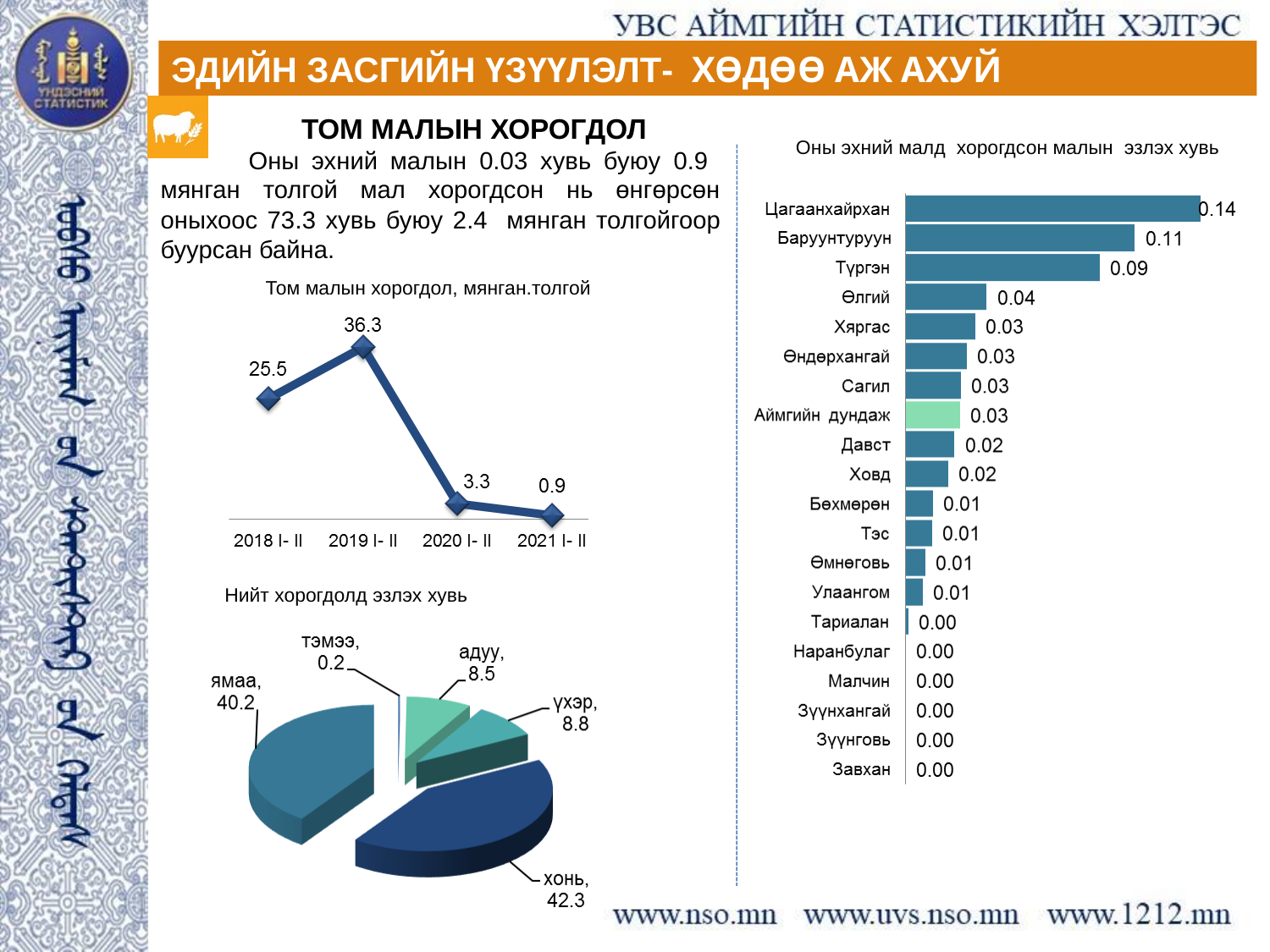
In the bar chart 'Оны эхний малд хорогдсон малын эзлэх хувь', which category has the highest value? Цагаанхайрхан In the line chart 'Том малын хорогдол, мянган.толгой', how many data points are plotted? 4 In the bar chart 'Оны эхний малд хорогдсон малын эзлэх хувь', what is the value for Баруунтуруун? 0.11 In the line chart 'Том малын хорогдол, мянган.толгой', which period has the lowest value? 2021 I- II In the pie chart 'Нийт хорогдолд эзлэх хувь', how many slices are there? 5 In the line chart 'Том малын хорогдол, мянган.толгой', what is the difference between the 2019 I- II and 2020 I- II values? 33.0 In the line chart 'Том малын хорогдол, мянган.толгой', what is the value for 2019 I- II? 36.3 In the pie chart 'Нийт хорогдолд эзлэх хувь', what is the value for хонь? 42.3 In the pie chart 'Нийт хорогдолд эзлэх хувь', which category has the smallest slice? тэмээ What type of chart is 'Оны эхний малд хорогдсон малын эзлэх хувь'? bar chart In the pie chart 'Нийт хорогдолд эзлэх хувь', which is larger, үхэр or адуу? үхэр In the line chart 'Том малын хорогдол, мянган.толгой', do the values rise or fall from 2019 I- II to 2021 I- II? fall